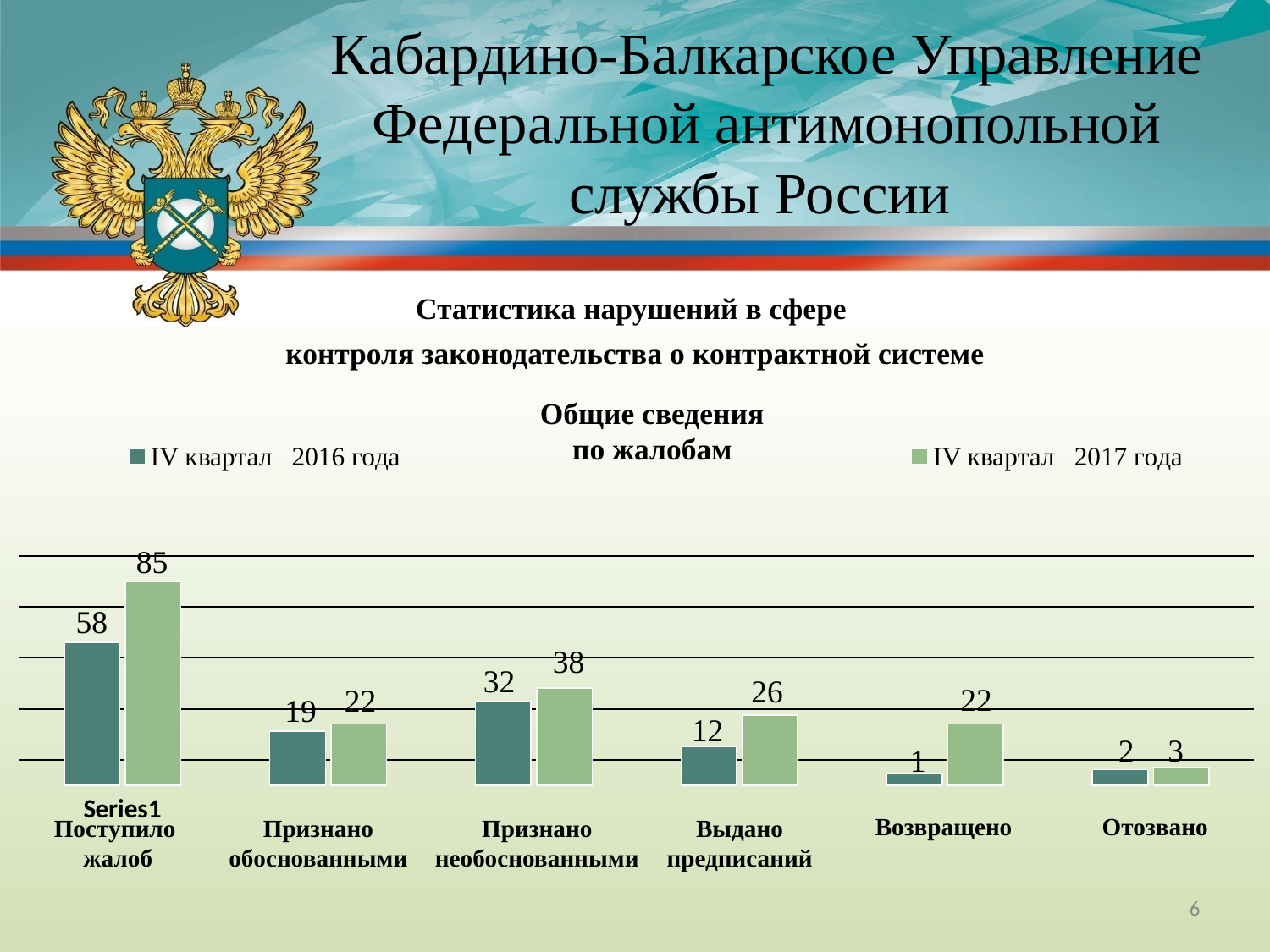
Which category has the lowest value in IV квартал 2016 года? Возвращено What is the difference between the two series' values for 'Выдано предписаний'? 14 What is the value for 'Выдано предписаний' in IV квартал 2016 года? 12 What is the value for 'Поступило жалоб' in IV квартал 2017 года? 85 Which category has the highest value in IV квартал 2016 года? Поступило жалоб What is the difference between the IV квартал 2017 года and IV квартал 2016 года values for 'Поступило жалоб'? 27 Which is larger for 'Признано необоснованными': the IV квартал 2016 года value or the IV квартал 2017 года value? IV квартал 2017 года What is the title of the chart? Общие сведения по жалобам How many series does the legend list? 2 What type of chart is shown on the slide? bar chart What is the value for 'Возвращено' in IV квартал 2017 года? 22 How many categories are shown on the x axis of the chart? 6